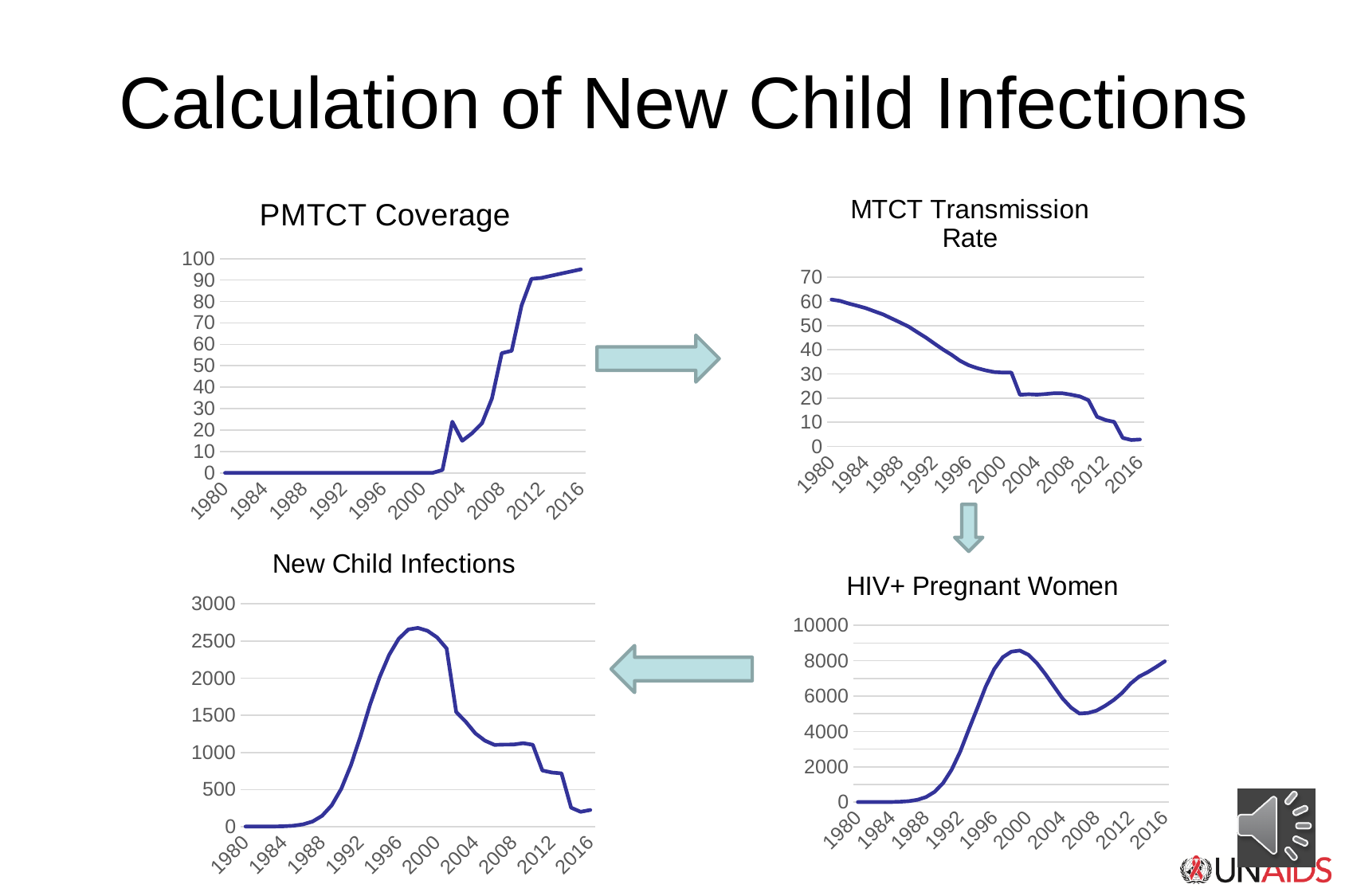
What kind of chart is the PMTCT Coverage chart? line chart In the New Child Infections chart, is the peak value greater or less than 2500? greater In the MTCT Transmission Rate chart, does the value rise or fall from 1980 to 2016? fall In the PMTCT Coverage chart, does the value rise or fall between 2000 and 2016? rise In the MTCT Transmission Rate chart, is the value for 2016 greater or less than 10? less In the New Child Infections chart, is the value for 2016 greater or less than 500? less How many charts are shown on the slide? 4 What is the title of the chart in the bottom-left of the slide? New Child Infections